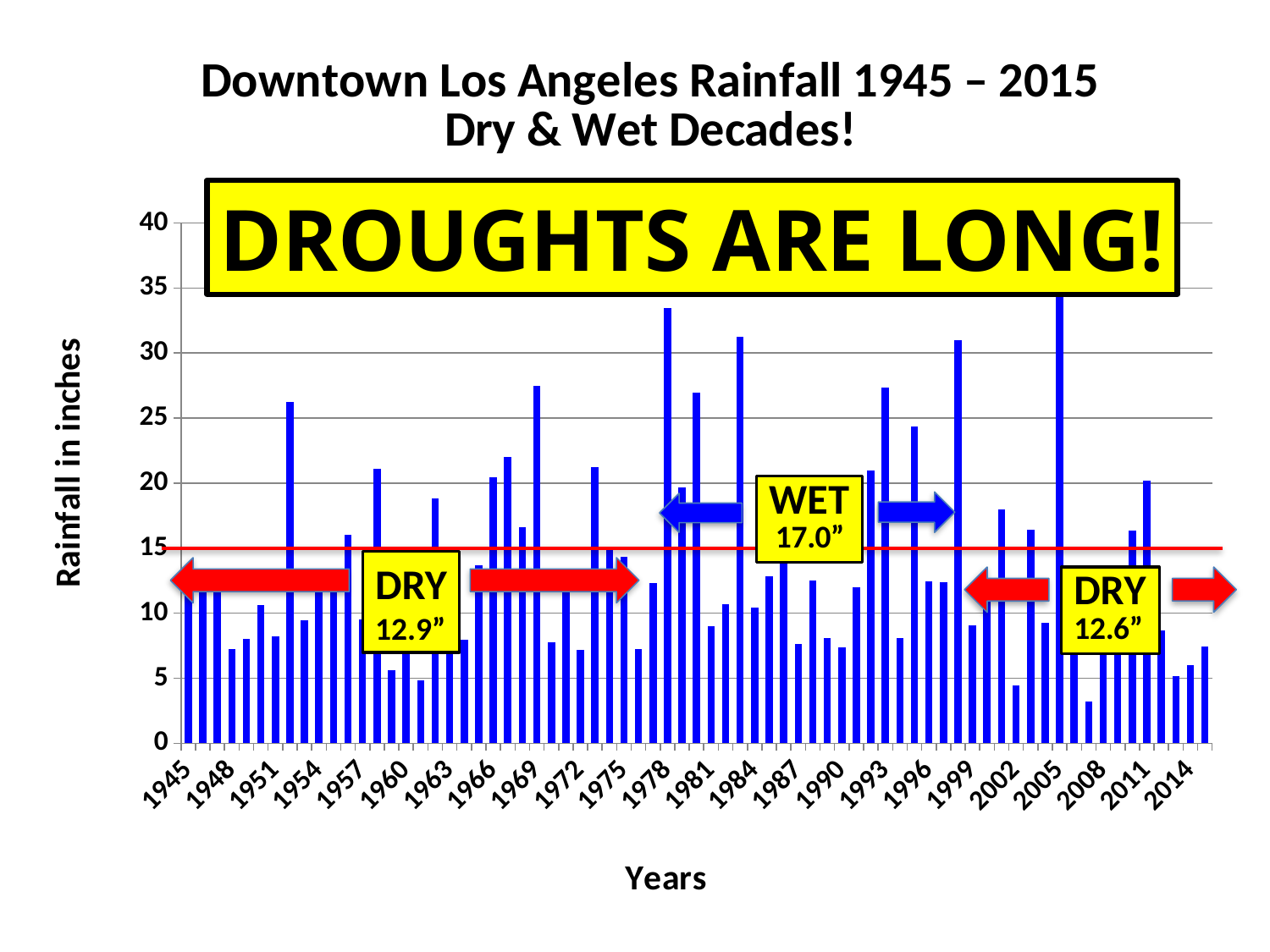
What average rainfall value is shown in the first DRY label (left side) on the chart? 12.9" Is the rainfall value for 1969 greater or less than 25? greater What kind of chart is shown on the slide? Bar chart Is the rainfall value for 1978 greater or less than 30? greater Is the rainfall value for 1960 greater or less than 10? less What average rainfall value is shown in the second DRY label (right side) on the chart? 12.6" What average rainfall value is shown in the WET label on the chart? 17.0" What is the title of the chart? Downtown Los Angeles Rainfall 1945 – 2015 Dry & Wet Decades! What is the label on the vertical axis of the chart? Rainfall in inches Which year has the highest rainfall bar on the chart? 2005